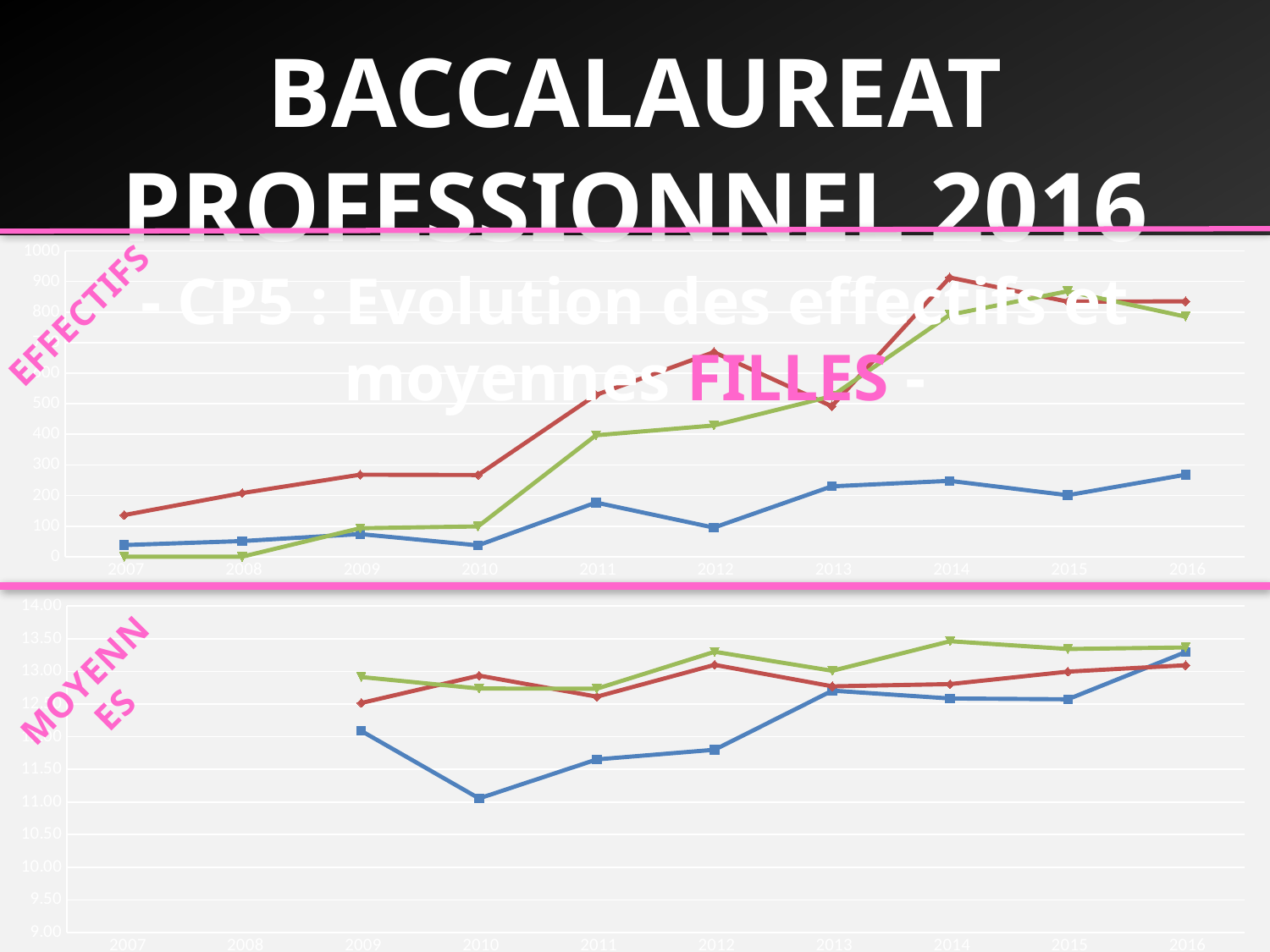
What kind of chart is the top chart labelled EFFECTIFS? line chart In the top chart (EFFECTIFS), in which year does the red line reach its highest value? 2014 In the top chart (EFFECTIFS), in which year does the blue line reach its highest value? 2016 In the bottom chart (MOYENNES), which line is higher in 2010, the green line or the blue line? the green line How many years are shown on the x axis of the top chart (EFFECTIFS)? 10 In the top chart (EFFECTIFS), does the blue line rise or fall overall from 2007 to 2016? rise In the top chart (EFFECTIFS), is the value of the green line in 2011 greater or less than 500? less How many lines are plotted on the bottom chart (MOYENNES)? 3 In the top chart (EFFECTIFS), which line is higher in 2016, the red line or the green line? the red line In the top chart (EFFECTIFS), is the value of the red line in 2014 greater or less than 800? greater In the bottom chart (MOYENNES), is the value of the blue line in 2010 greater or less than 11.50? less In the bottom chart (MOYENNES), in which year does the blue line reach its lowest value? 2010